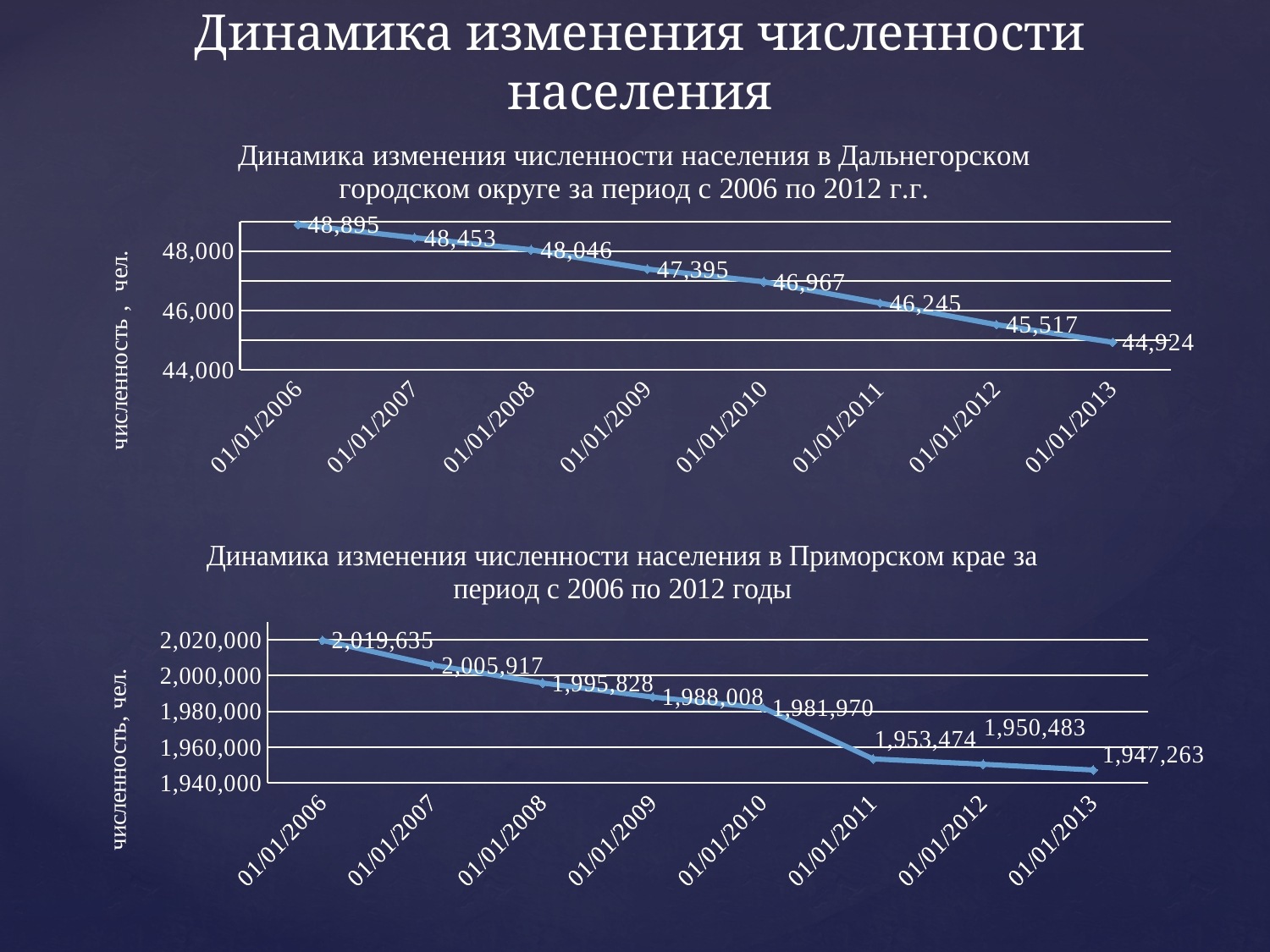
On the bottom chart, is the value for 01/01/2009 greater or less than 1,980,000? greater On the bottom chart, which date has the highest population value? 01/01/2006 On the top chart, what is the population value for 01/01/2013? 44,924 What type of chart is the bottom chart? line chart On the top chart, which date has the lowest population value? 01/01/2013 On the top chart, which is larger: the value for 01/01/2008 or the value for 01/01/2010? 01/01/2008 On the bottom chart, what is the population value for 01/01/2011? 1,953,474 On the top chart, do the values rise or fall from 01/01/2006 to 01/01/2013? fall On the bottom chart, what is the difference between the values for 01/01/2010 and 01/01/2011? 28,496 How many data points are plotted on the top chart? 8 On the top chart, what is the difference between the values for 01/01/2006 and 01/01/2013? 3,971 On the top chart, what is the population value for 01/01/2006? 48,895